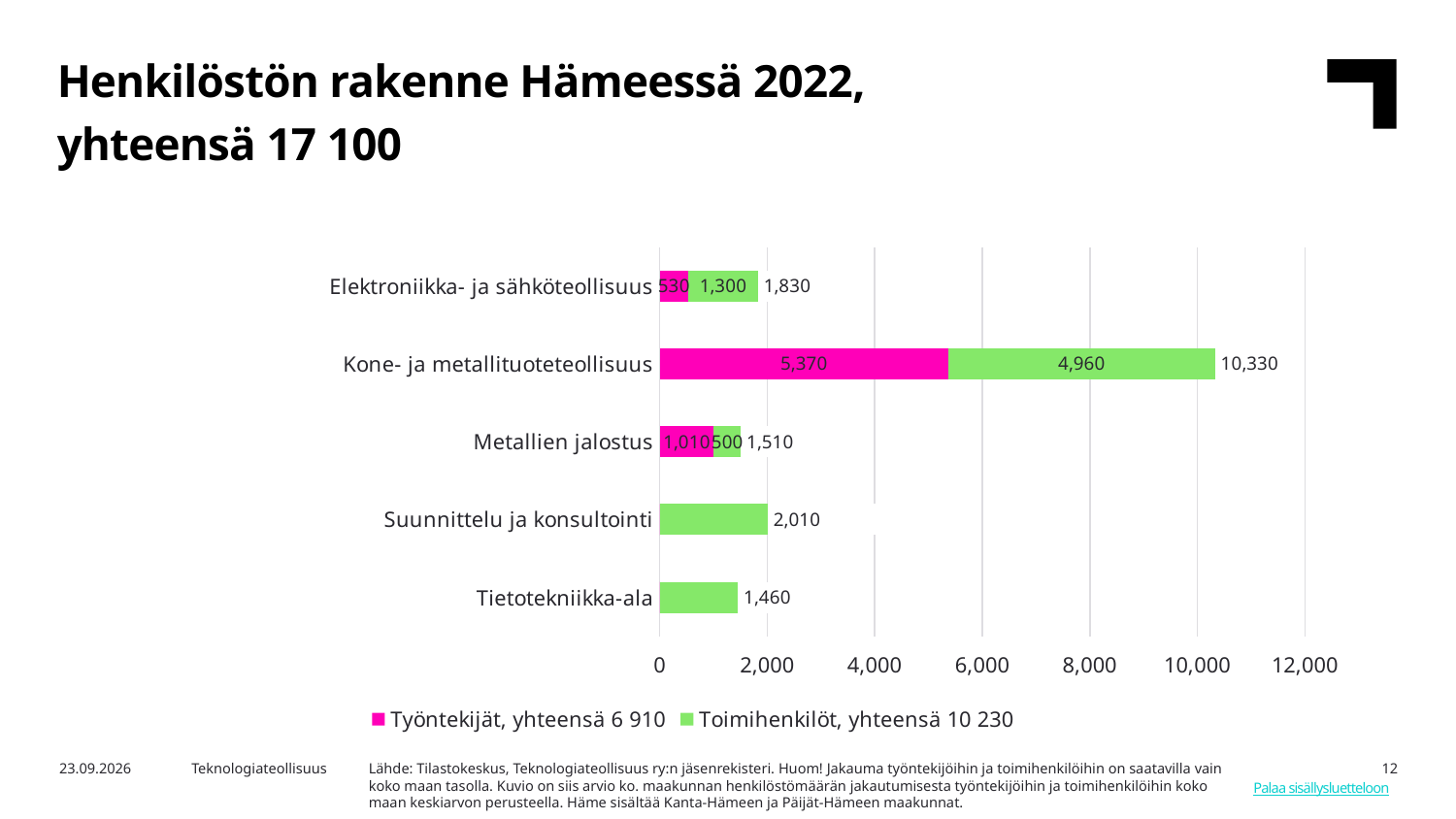
What is the Toimihenkilöt value for Tietotekniikka-ala? 1,460 Which category has the lowest total? Tietotekniikka-ala What kind of chart is shown on the slide? Stacked bar chart What is the difference between the Työntekijät and Toimihenkilöt values for Kone- ja metallituoteteollisuus? 410 What is the total for the Metallien jalostus bar? 1,510 What is the total for the Kone- ja metallituoteteollisuus bar? 10,330 Which is larger: the total for Suunnittelu ja konsultointi or the total for Elektroniikka- ja sähköteollisuus? Suunnittelu ja konsultointi What is the Toimihenkilöt value for Elektroniikka- ja sähköteollisuus? 1,300 Which category has the highest total? Kone- ja metallituoteteollisuus How many series does the legend list? 2 What is the Työntekijät value for Kone- ja metallituoteteollisuus? 5,370 How many categories are shown on the chart? 5